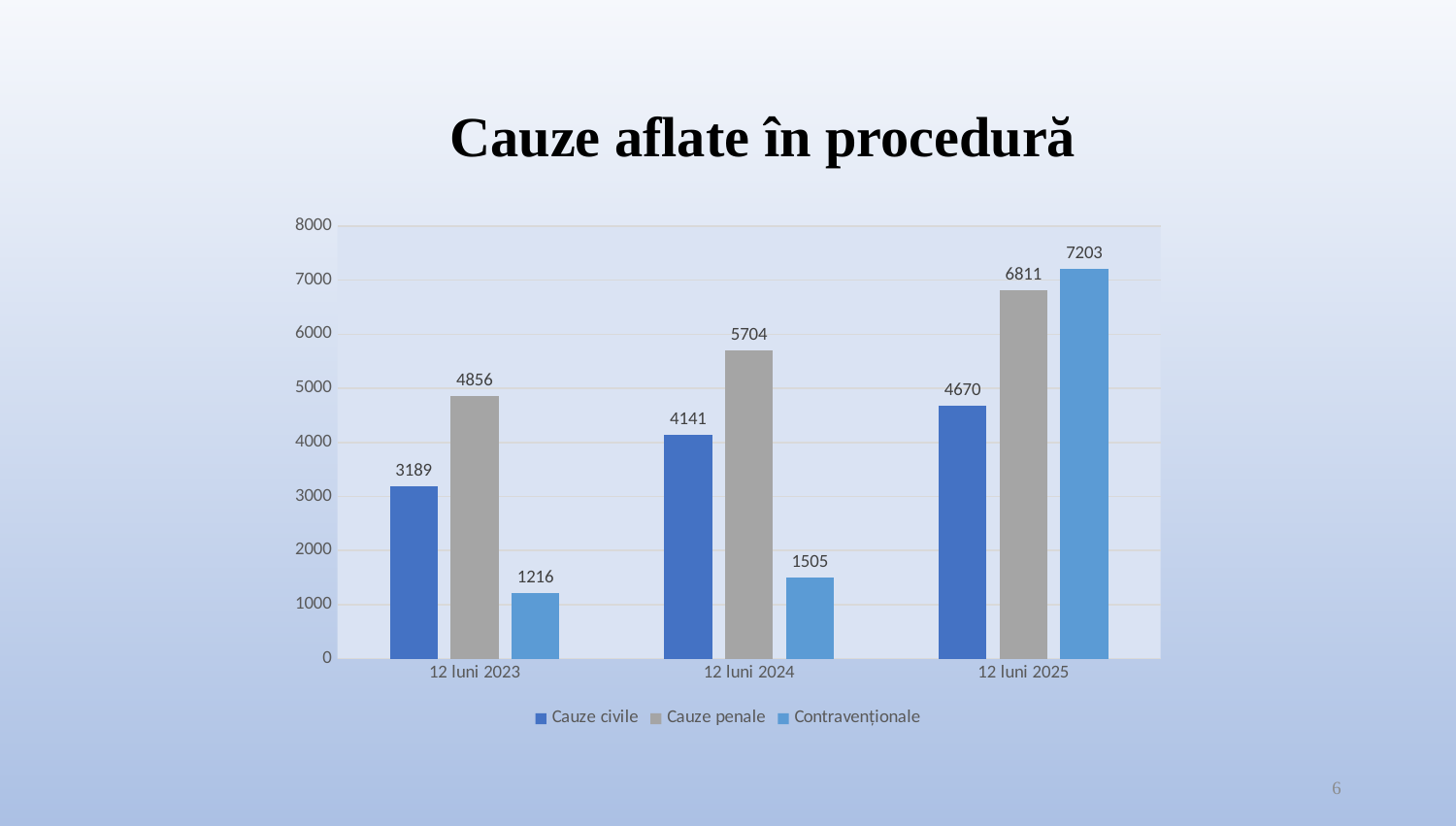
Do the values for Cauze civile rise or fall from 12 luni 2023 to 12 luni 2025? Rise Which series has the lowest value in 12 luni 2023? Contravenționale What is the value for Cauze penale in 12 luni 2024? 5704 What is the title of the chart? Cauze aflate în procedură Which period has the highest value for Contravenționale? 12 luni 2025 Which is larger in 12 luni 2025: Cauze penale or Contravenționale? Contravenționale What is the value for Contravenționale in 12 luni 2023? 1216 What kind of chart is shown on the slide? Bar chart How many periods are shown on the x axis? 3 What is the value for Cauze civile in 12 luni 2025? 4670 What is the difference between Cauze penale in 12 luni 2025 and 12 luni 2024? 1107 How many series does the legend list? 3